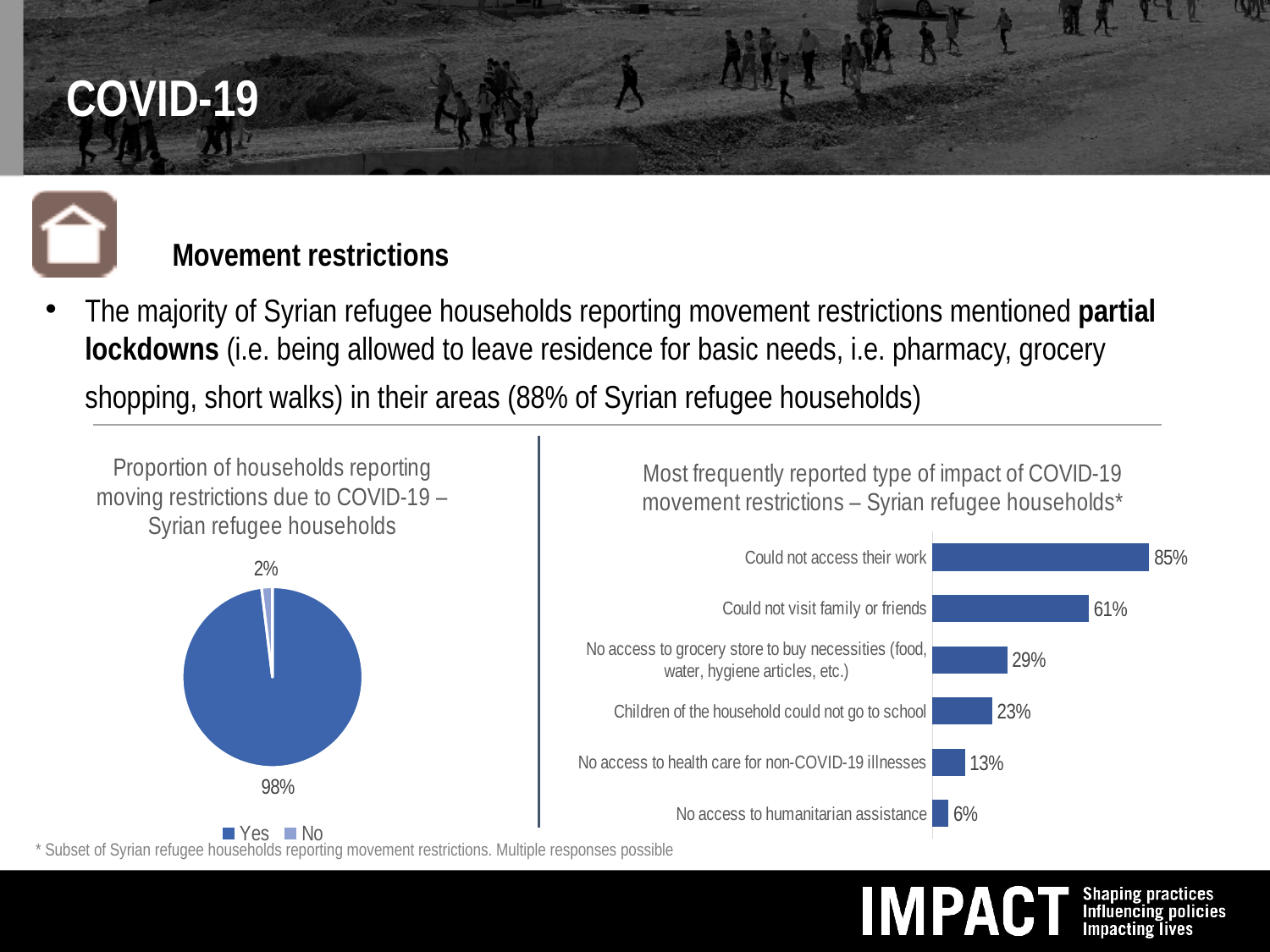
In the pie chart 'Proportion of households reporting moving restrictions due to COVID-19 – Syrian refugee households', what share of households answered Yes? 98% In the chart on the right, which is larger: 'No access to grocery store to buy necessities' or 'No access to health care for non-COVID-19 illnesses'? No access to grocery store to buy necessities In the chart on the right, which category has the highest value? Could not access their work In the chart 'Most frequently reported type of impact of COVID-19 movement restrictions – Syrian refugee households', what is the value for 'Could not access their work'? 85% What type of chart is the chart on the left of the slide? Pie chart How many categories are shown in the bar chart on the right? 6 In the chart on the right, what is the difference between 'Could not access their work' and 'Could not visit family or friends'? 24% How many entries does the legend of the pie chart on the left list? 2 What type of chart is the chart on the right of the slide? Bar chart In the chart on the right, what is the value for 'Children of the household could not go to school'? 23% In the pie chart on the left, what share of households answered No? 2% In the chart on the right, which category has the lowest value? No access to humanitarian assistance